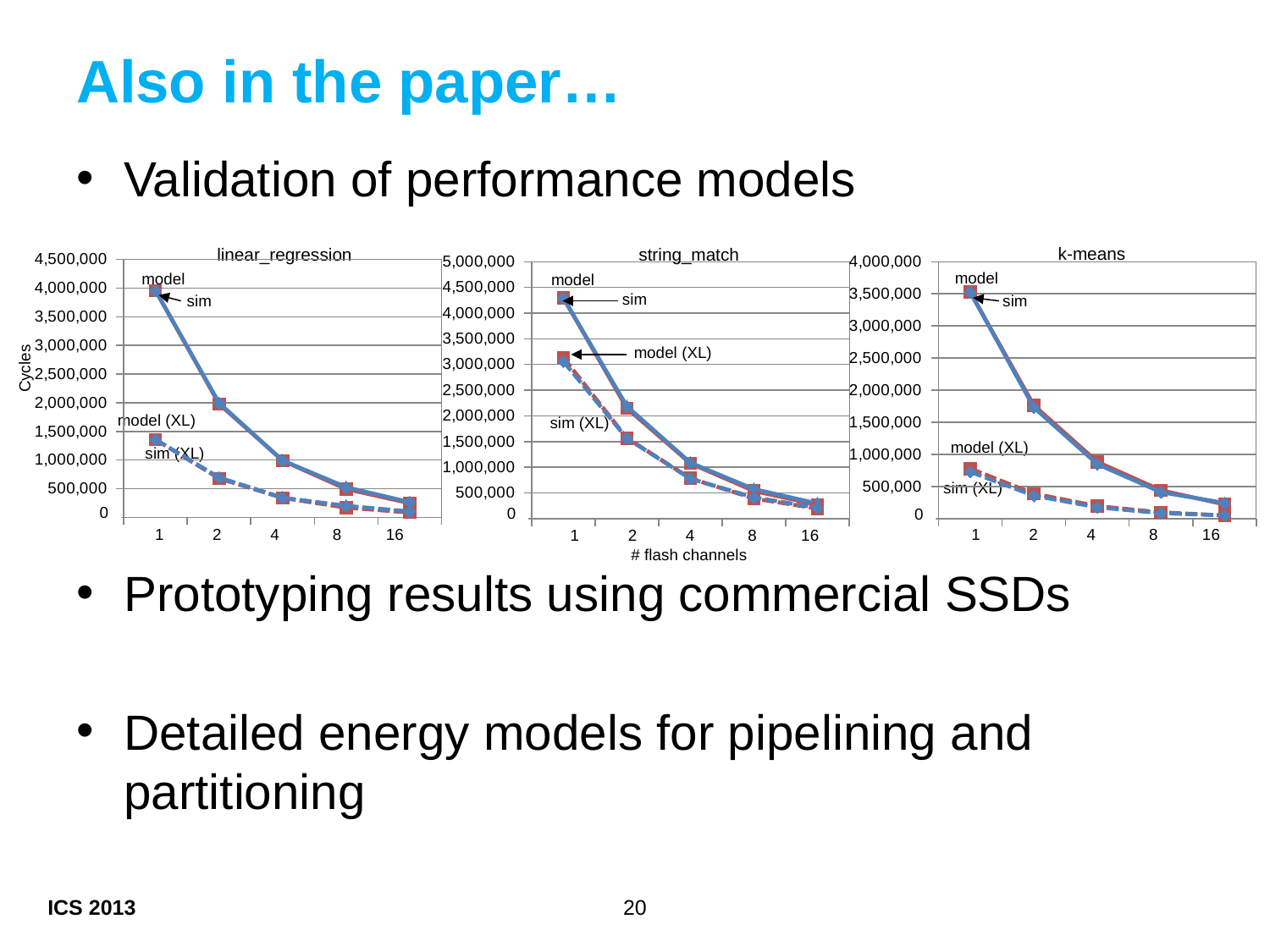
In the string_match chart, is the value for model at 1 flash channel greater or less than 4,000,000? greater In the linear_regression chart, is the value for model at 16 flash channels greater or less than 500,000? less What is the title of the rightmost chart on the slide? k-means What kind of chart is the linear_regression chart? line chart In the k-means chart, is the value for model at 1 flash channel greater or less than 3,000,000? greater How many flash channel values are plotted along the x axis of the string_match chart? 5 In the k-means chart, do the cycle values rise or fall as the number of flash channels increases? fall What is the label on the shared x axis beneath the string_match chart? # flash channels